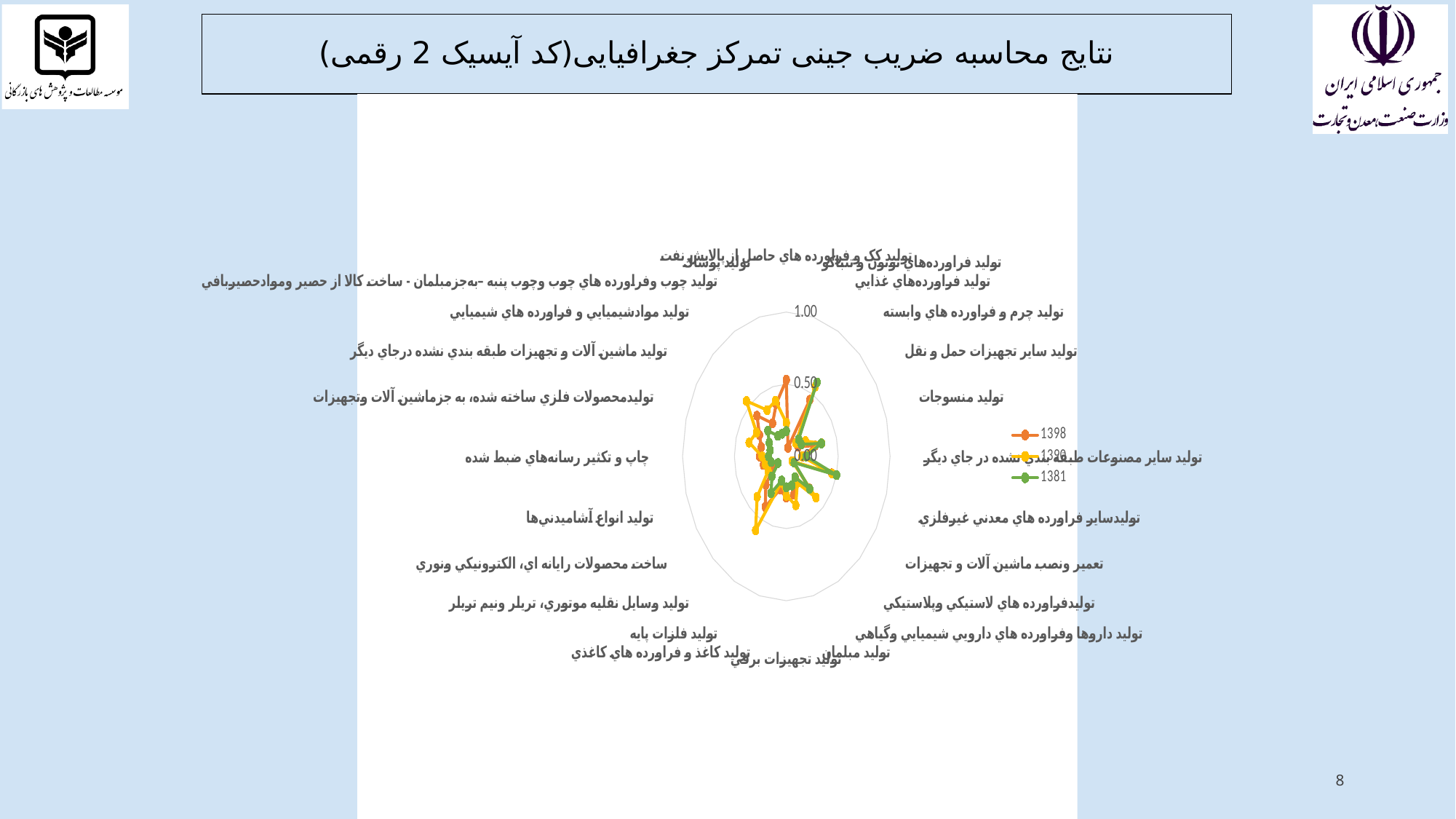
Which colour represents the 1398 series in the chart? orange Are the plotted values for the 1398 series greater or less than 1.00? less How many series does the chart's legend list? 3 What is the highest tick value shown on the chart's radial axis? 1.00 Are the plotted values for the 1381 series greater or less than 1.00? less What is the title of the slide containing the chart? نتایج محاسبه ضریب جینی تمرکز جغرافیایی(کد آیسیک 2 رقمی) What is the lowest tick value shown on the chart's radial axis? 0.00 What kind of chart is shown on the slide? radar chart Which series is shown in green in the chart? 1381